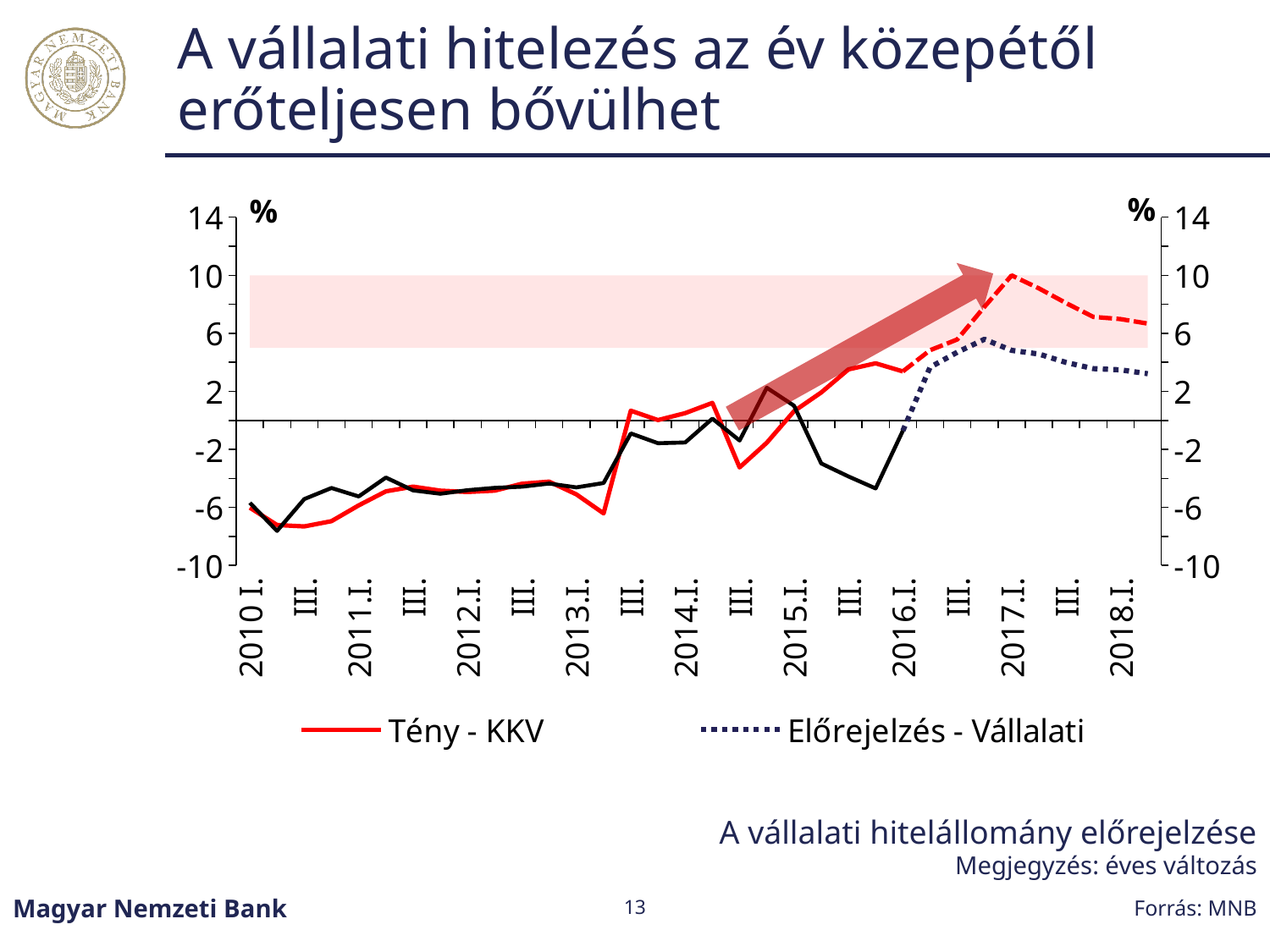
Is the value of Előrejelzés - Vállalati at 2018 I. greater or less than 6? less How many period labels are shown on the x axis? 17 What kind of chart is shown on the slide? line chart What is the title of the chart given below it? A vállalati hitelállomány előrejelzése Does the Előrejelzés - Vállalati series rise or fall from 2016 III. to 2018 I.? fall Is the value of Előrejelzés - Vállalati at 2018 I. greater or less than 2? greater How many series does the chart legend list? 2 Is the value of Tény - KKV at 2016 I. greater or less than 2? greater Does the Tény - KKV series rise or fall overall from 2010 I. to 2016 I.? rise What unit is shown on the chart's vertical axes? %